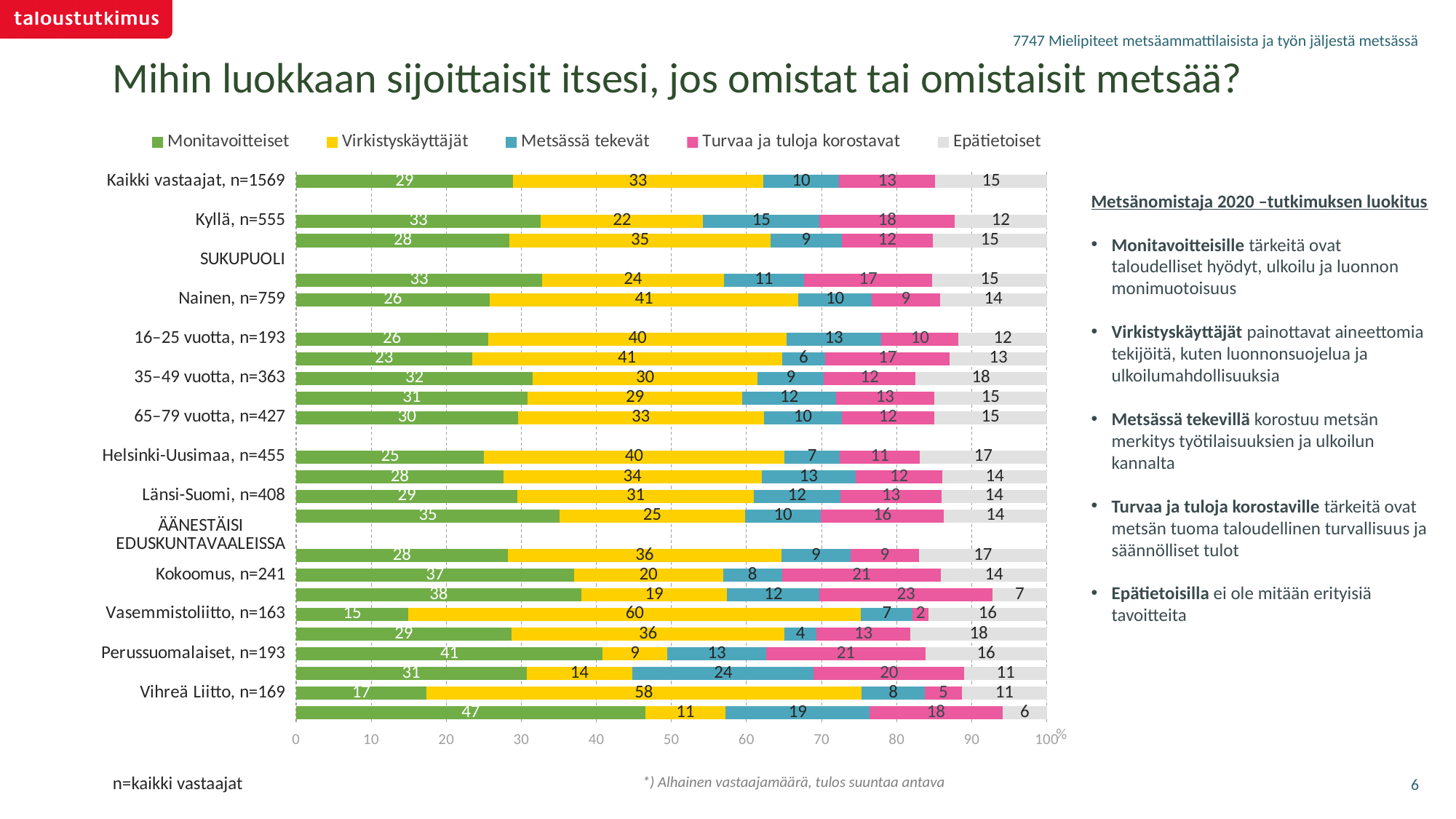
Which is larger for Vihreä Liitto, n=169: the Monitavoitteiset value or the Virkistyskäyttäjät value? Virkistyskäyttäjät What is the Epätietoiset value for Helsinki-Uusimaa, n=455? 17 Which series is shown in green in the legend? Monitavoitteiset Among the labelled party rows (Kokoomus, Vasemmistoliitto, Perussuomalaiset, Vihreä Liitto), which has the highest Monitavoitteiset value? Perussuomalaiset, n=193 What kind of chart is shown on the slide? bar chart What is the Virkistyskäyttäjät value for Kaikki vastaajat, n=1569? 33 What is the Monitavoitteiset value for Kyllä, n=555? 33 What is the Turvaa ja tuloja korostavat value for Kokoomus, n=241? 21 How many series does the legend list? 5 What is the difference between the Virkistyskäyttäjät values for Nainen, n=759 and Kyllä, n=555? 19 What is the Virkistyskäyttäjät value for Vasemmistoliitto, n=163? 60 What is the Metsässä tekevät value for Perussuomalaiset, n=193? 13